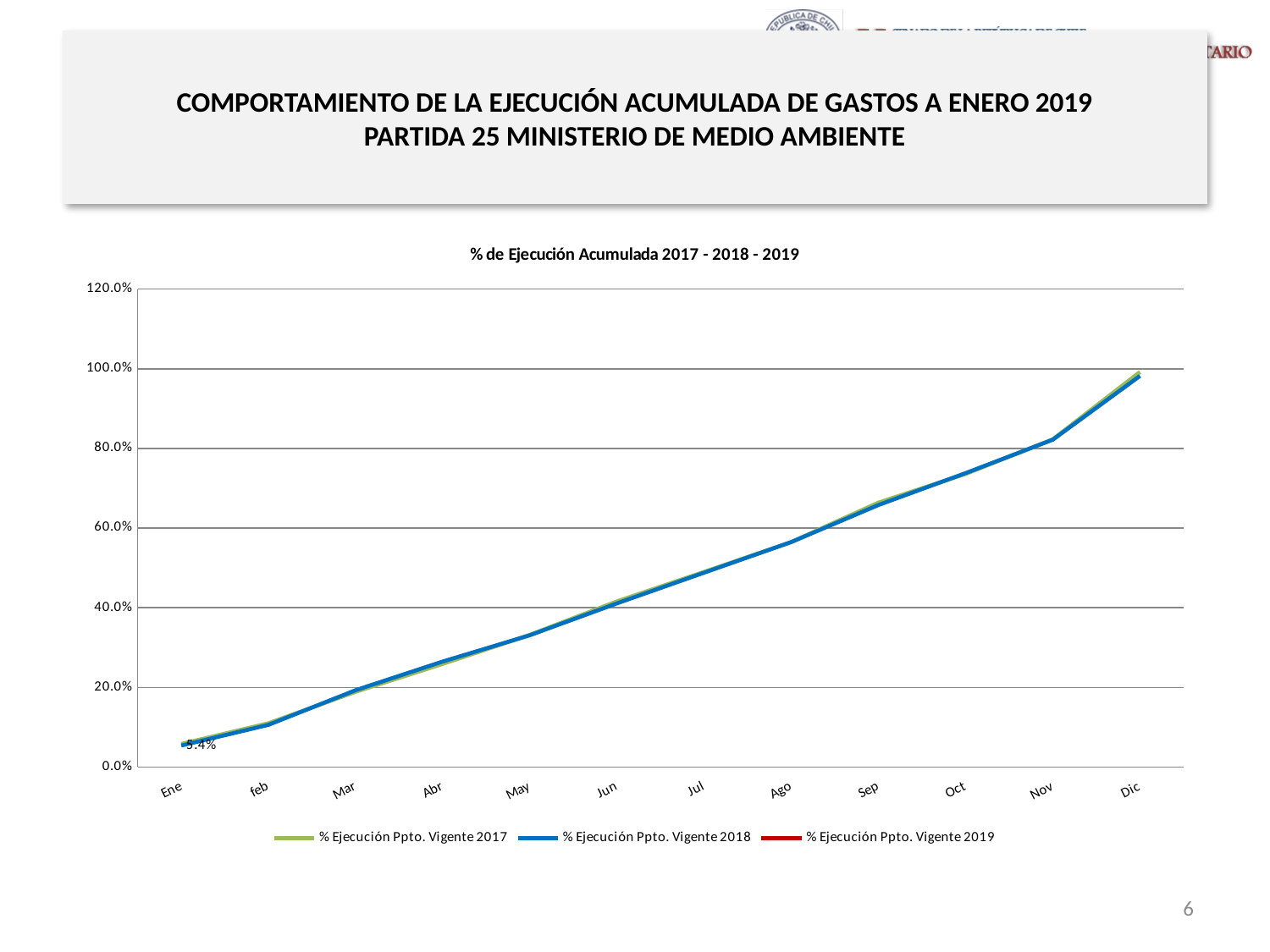
In which month does % Ejecución Ppto. Vigente 2018 reach its highest value? Dic How many series does the legend of the chart list? 3 In which month is % Ejecución Ppto. Vigente 2018 at its lowest value? Ene What kind of chart is shown on the slide? line chart Which is larger for % Ejecución Ppto. Vigente 2018: the value at Nov or the value at Mar? Nov Do the values for % Ejecución Ppto. Vigente 2018 rise or fall from Ene to Dic? rise What is the title of the chart? % de Ejecución Acumulada 2017 - 2018 - 2019 How many months are shown along the x axis of the chart? 12 Is the value for % Ejecución Ppto. Vigente 2018 at Dic greater or less than 80.0%? greater What value is printed as a data label at Ene on the chart? 5.4% Is the value for % Ejecución Ppto. Vigente 2018 at Jun greater or less than 60.0%? less Is the value for % Ejecución Ppto. Vigente 2017 at Mar greater or less than 40.0%? less